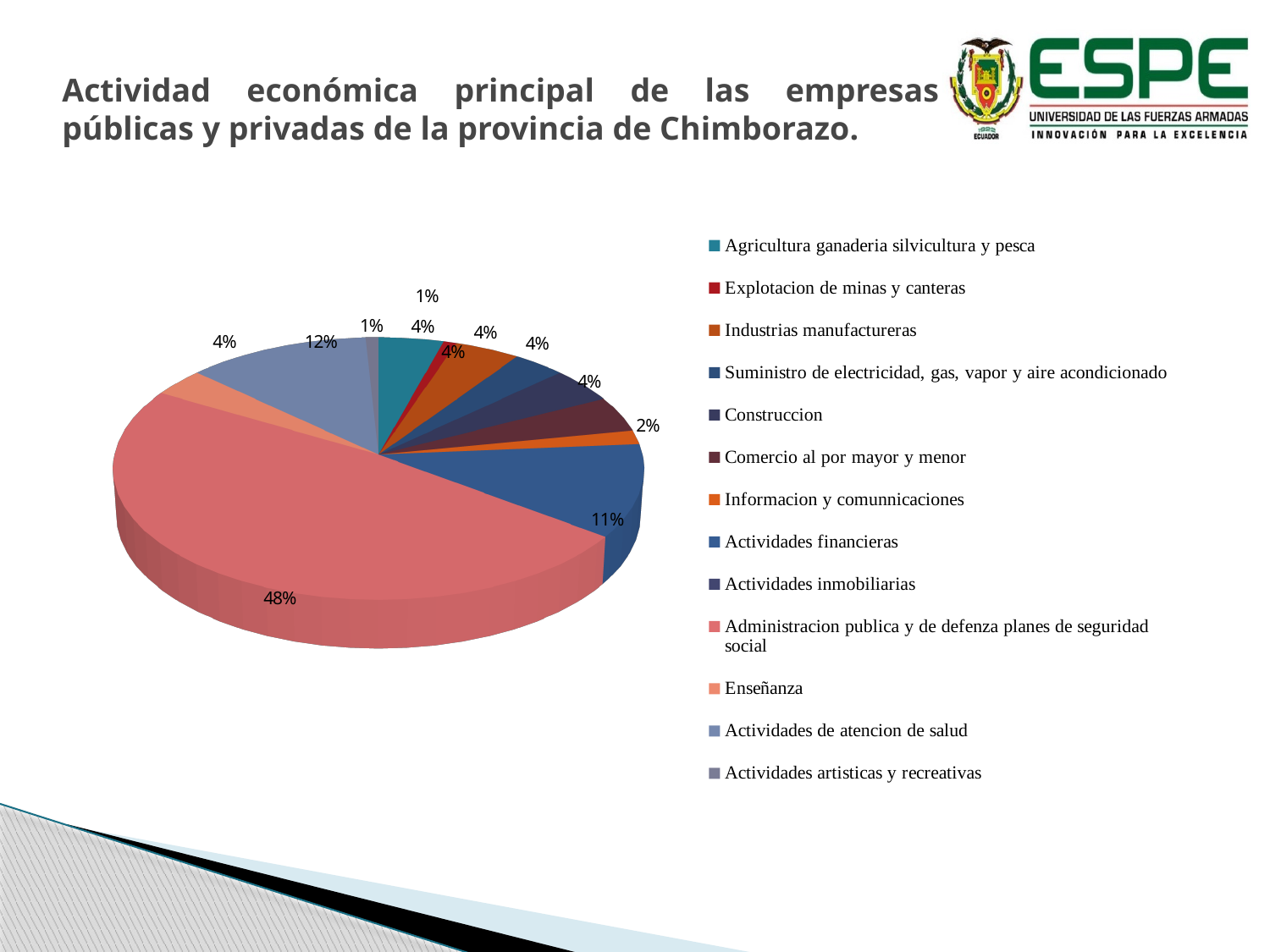
What percentage is shown for 'Actividades financieras'? 11% Which is larger, the slice for 'Actividades financieras' or the slice for 'Actividades de atencion de salud'? Actividades de atencion de salud What percentage is shown for 'Actividades de atencion de salud'? 12% Which category has the largest slice of the pie? Administracion publica y de defenza planes de seguridad social What percentage is shown for 'Enseñanza'? 4% How many entries does the legend list? 13 What is the difference in percentage points between 'Administracion publica y de defenza planes de seguridad social' and 'Actividades de atencion de salud'? 36 What percentage is shown for 'Informacion y comunnicaciones'? 2% What share of the pie does 'Administracion publica y de defenza planes de seguridad social' have? 48% What is the title of the slide? Actividad económica principal de las empresas públicas y privadas de la provincia de Chimborazo. Which legend entry is listed first? Agricultura ganaderia silvicultura y pesca What kind of chart is shown on the slide? pie chart